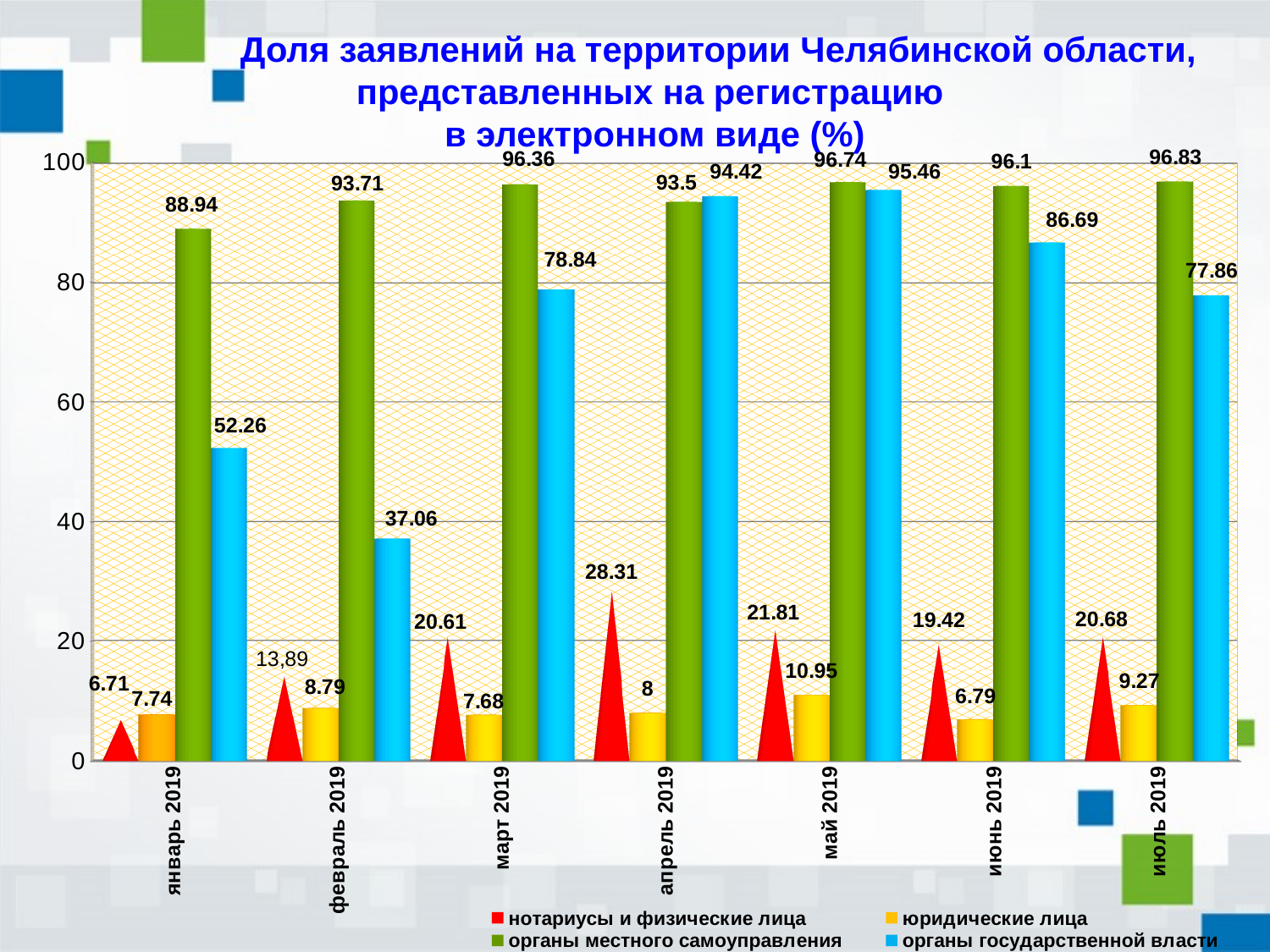
What is the difference between the values for органы местного самоуправления and органы государственной власти in январь 2019? 36.68 What is the value for органы государственной власти in март 2019? 78.84 How many months are shown on the x axis? 7 In which month is the value for нотариусы и физические лица the highest? апрель 2019 What kind of chart is shown on the slide? bar chart Which colour represents органы государственной власти in the legend? blue What is the value for нотариусы и физические лица in апрель 2019? 28.31 What is the value for органы местного самоуправления in январь 2019? 88.94 What is the value for юридические лица in май 2019? 10.95 Which is larger in июнь 2019: the value for нотариусы и физические лица or the value for юридические лица? нотариусы и физические лица In which month is the value for органы государственной власти the lowest? февраль 2019 How many series does the legend list? 4